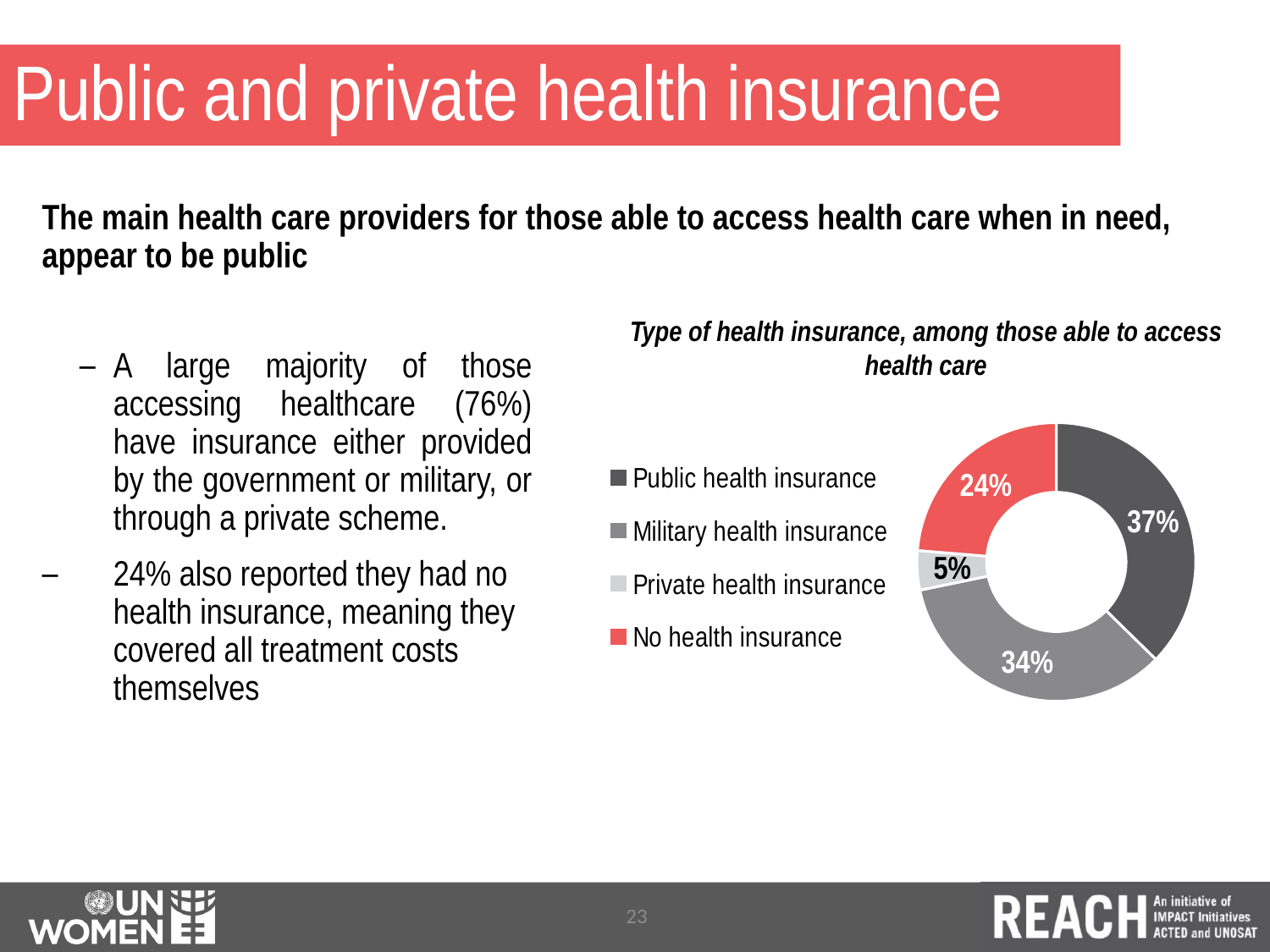
How many categories does the chart show? 4 What share of those able to access health care have public health insurance? 37% What kind of chart is shown on the slide? Doughnut chart What is the title of the chart? Type of health insurance, among those able to access health care Which type of health insurance has the largest share in the chart? Public health insurance Which category is shown in red in the chart? No health insurance Which is larger: the share with military health insurance or the share with no health insurance? Military health insurance What share of those able to access health care have military health insurance? 34% What share of those able to access health care have private health insurance? 5% Which category has the smallest share in the chart? Private health insurance What share of those able to access health care have no health insurance? 24% What is the difference in percentage points between public health insurance and no health insurance? 13